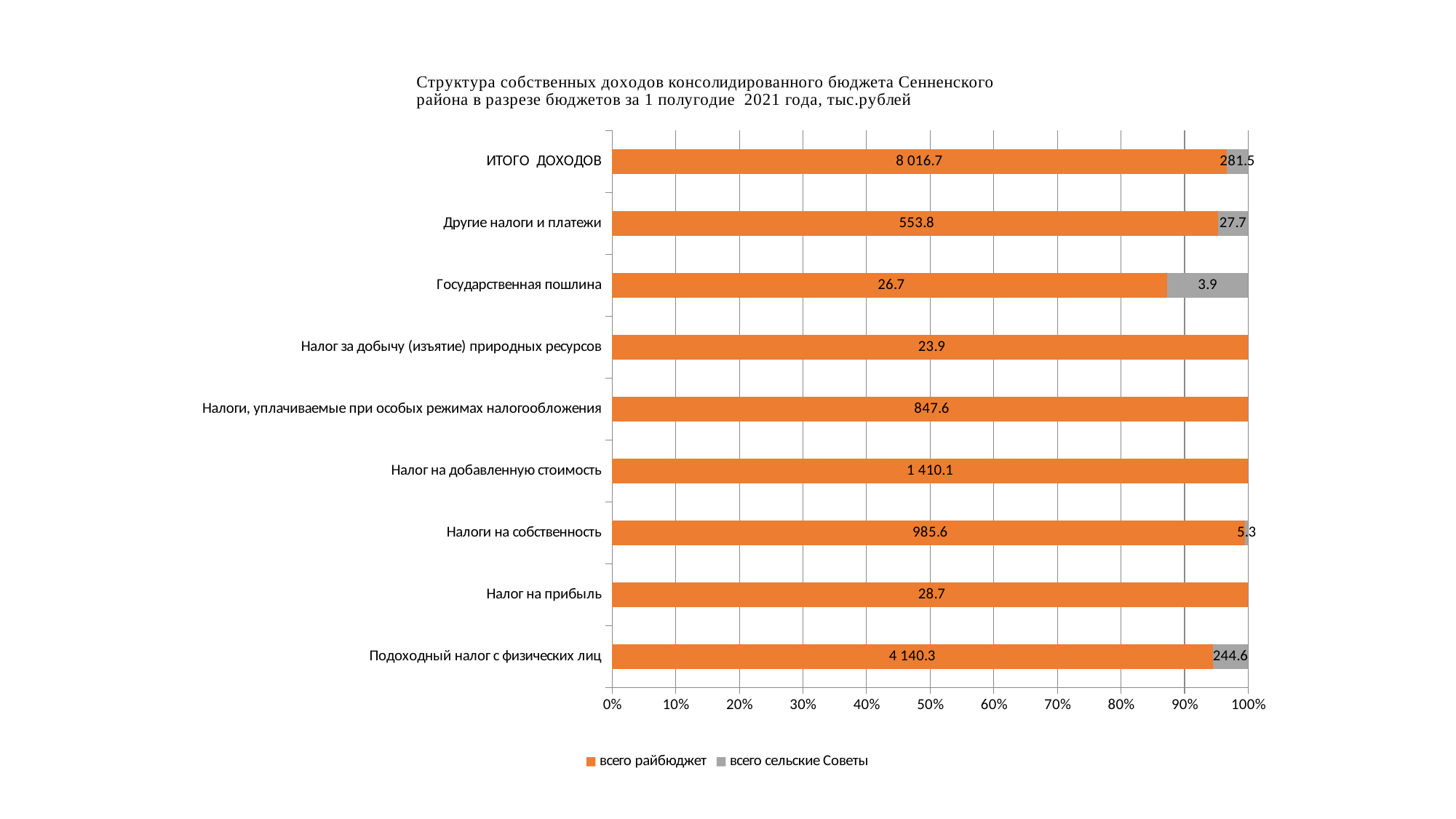
What is the total of the two series for 'Государственная пошлина'? 30.6 What is the value of 'всего сельские Советы' for 'ИТОГО ДОХОДОВ'? 281.5 What is the difference between the 'всего сельские Советы' values for 'ИТОГО ДОХОДОВ' and 'Подоходный налог с физических лиц'? 36.9 What kind of chart is shown on the slide? bar chart Excluding 'ИТОГО ДОХОДОВ', which category has the highest 'всего райбюджет' value? Подоходный налог с физических лиц What is the value of 'всего райбюджет' for 'Налог на добавленную стоимость'? 1 410.1 What is the value of 'всего райбюджет' for 'Подоходный налог с физических лиц'? 4 140.3 What is the value of 'всего сельские Советы' for 'Государственная пошлина'? 3.9 How many categories are plotted on the chart? 9 Is the share of 'всего райбюджет' in the 'Государственная пошлина' bar greater or less than 90%? less How many series does the legend list? 2 Which category has the lowest 'всего райбюджет' value? Налог за добычу (изъятие) природных ресурсов